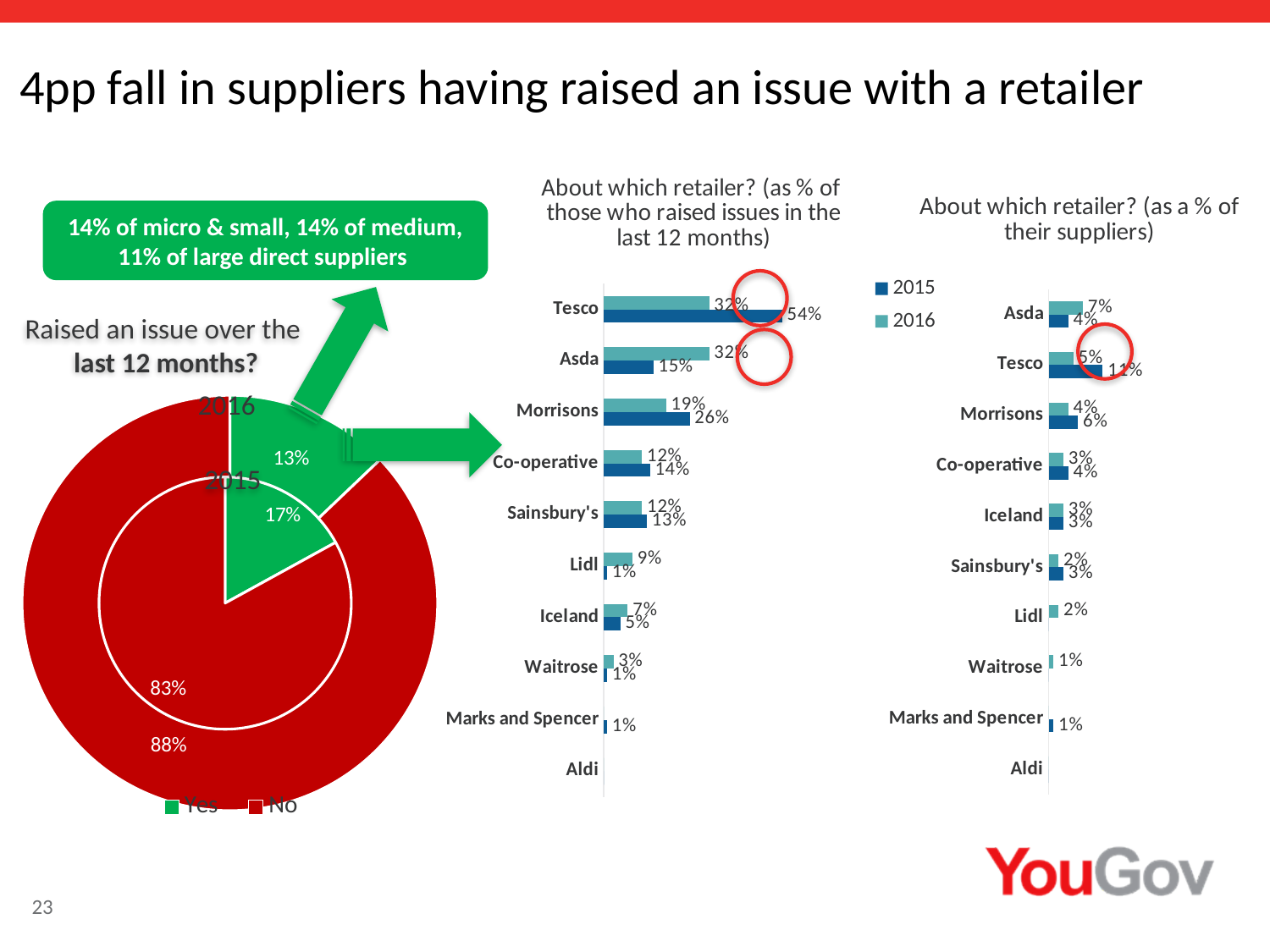
What kind of chart is 'About which retailer? (as a % of their suppliers)'? Bar chart In the chart 'About which retailer? (as a % of their suppliers)', which retailer has the highest 2016 value? Asda In the chart 'About which retailer? (as a % of their suppliers)', what is the 2016 value for Asda? 7% In the chart 'About which retailer? (as % of those who raised issues in the last 12 months)', is the 2016 value for Lidl larger or the 2015 value? 2016 In the chart 'About which retailer? (as a % of their suppliers)', what is the 2015 value for Tesco? 11% In the chart 'About which retailer? (as % of those who raised issues in the last 12 months)', what is the 2016 value for Asda? 32% In the chart 'About which retailer? (as % of those who raised issues in the last 12 months)', what is the 2015 value for Tesco? 54% In the chart 'About which retailer? (as % of those who raised issues in the last 12 months)', which retailer has the highest 2015 value? Tesco How many series does the legend list for the retailer bar charts? 2 In the pie chart 'Raised an issue over the last 12 months?', what share of suppliers answered No in 2015? 83% In the chart 'About which retailer? (as % of those who raised issues in the last 12 months)', what is the difference between the 2015 and 2016 values for Morrisons? 7% In the pie chart 'Raised an issue over the last 12 months?', what share of suppliers answered Yes in 2016? 13%